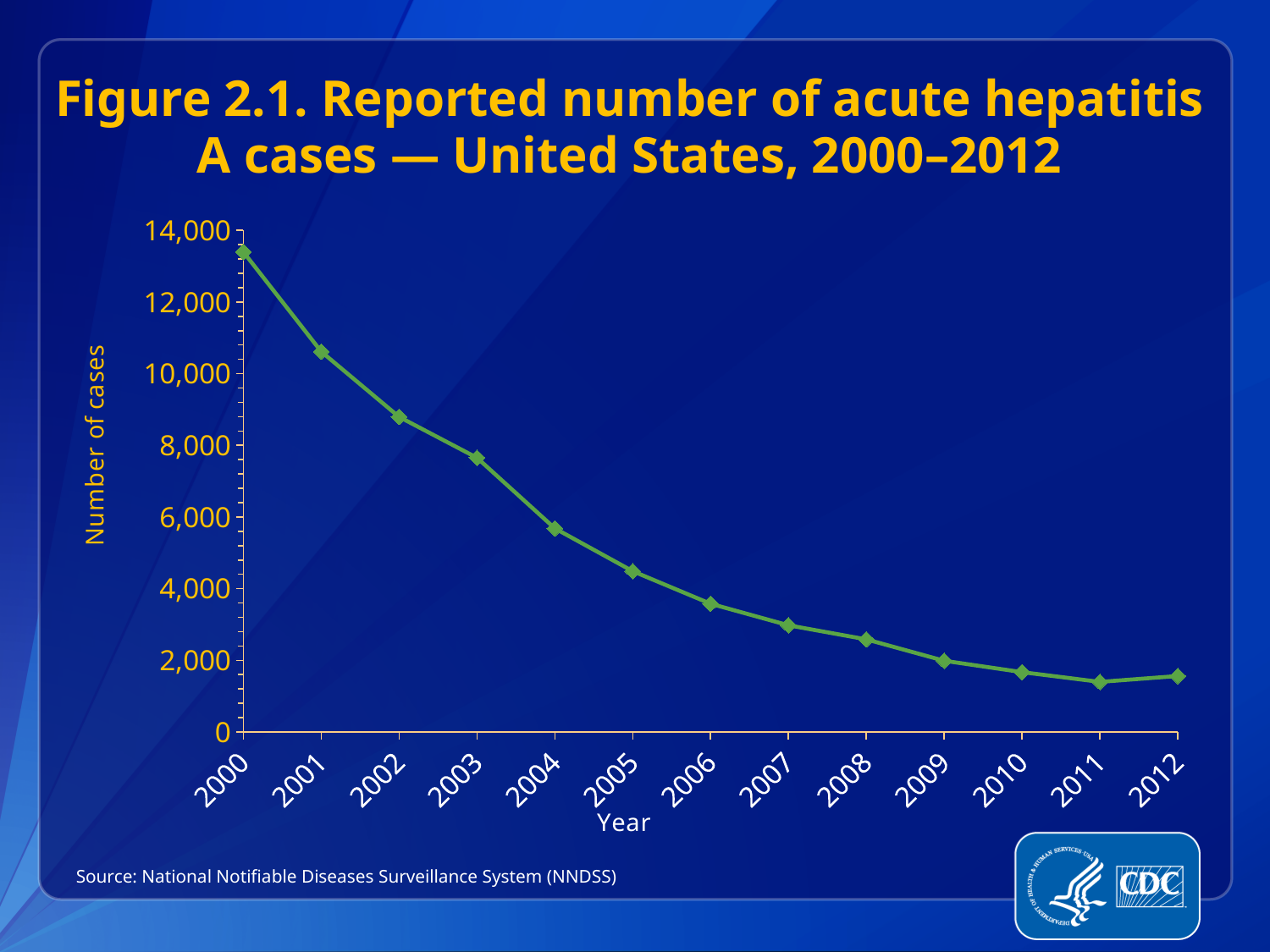
Which year has the highest reported number of acute hepatitis A cases? 2000 Is the number of cases in 2006 greater or less than 4,000? less Is the number of cases in 2004 greater or less than 6,000? less What kind of chart is shown on the slide? line chart Is the number of cases in 2002 greater or less than 10,000? less How many years (data points) are plotted on the chart? 13 What is the label of the vertical axis? Number of cases Which year had more reported cases, 2002 or 2005? 2002 Do the reported numbers of acute hepatitis A cases generally rise or fall from 2000 to 2012? fall